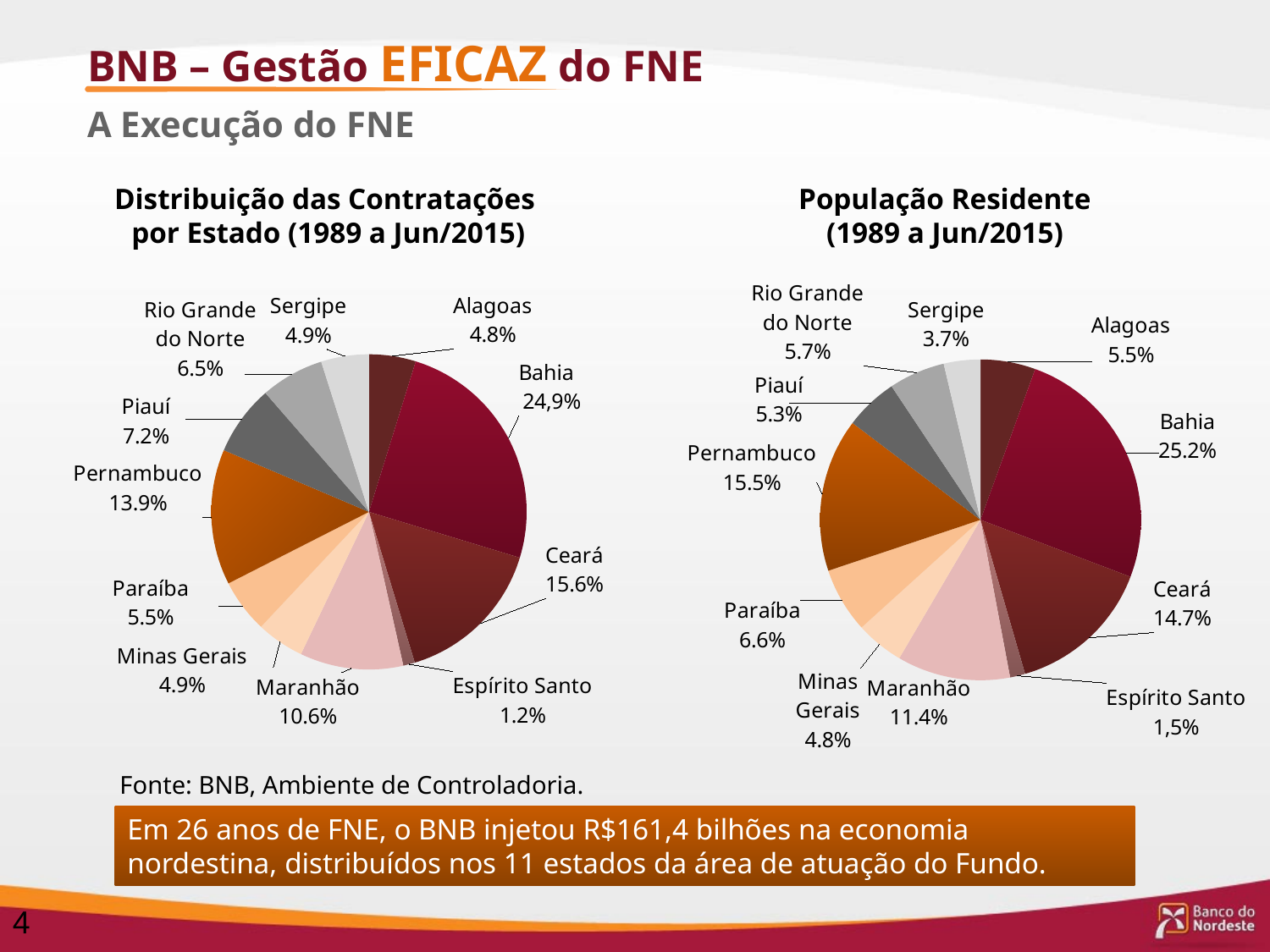
What type of chart is used for 'População Residente (1989 a Jun/2015)'? Pie chart What is the title of the chart on the right side of the slide? População Residente (1989 a Jun/2015) In the 'Distribuição das Contratações por Estado' chart, what share does Espírito Santo have? 1.2% In the 'Distribuição das Contratações por Estado' chart, what share does Bahia have? 24,9% In the 'População Residente' chart, which is larger, the share of Maranhão or the share of Paraíba? Maranhão In the 'Distribuição das Contratações por Estado' chart, what is the difference between the shares of Ceará and Pernambuco? 1.7% How many states are shown in the 'Distribuição das Contratações por Estado' chart? 11 In the 'População Residente' chart, what share does Pernambuco have? 15.5% In the 'Distribuição das Contratações por Estado' chart, which state has the largest slice? Bahia In the 'População Residente' chart, what share does Sergipe have? 3.7% In the 'Distribuição das Contratações por Estado' chart, what share does Piauí have? 7.2% In the 'População Residente' chart, which state has the smallest slice? Espírito Santo